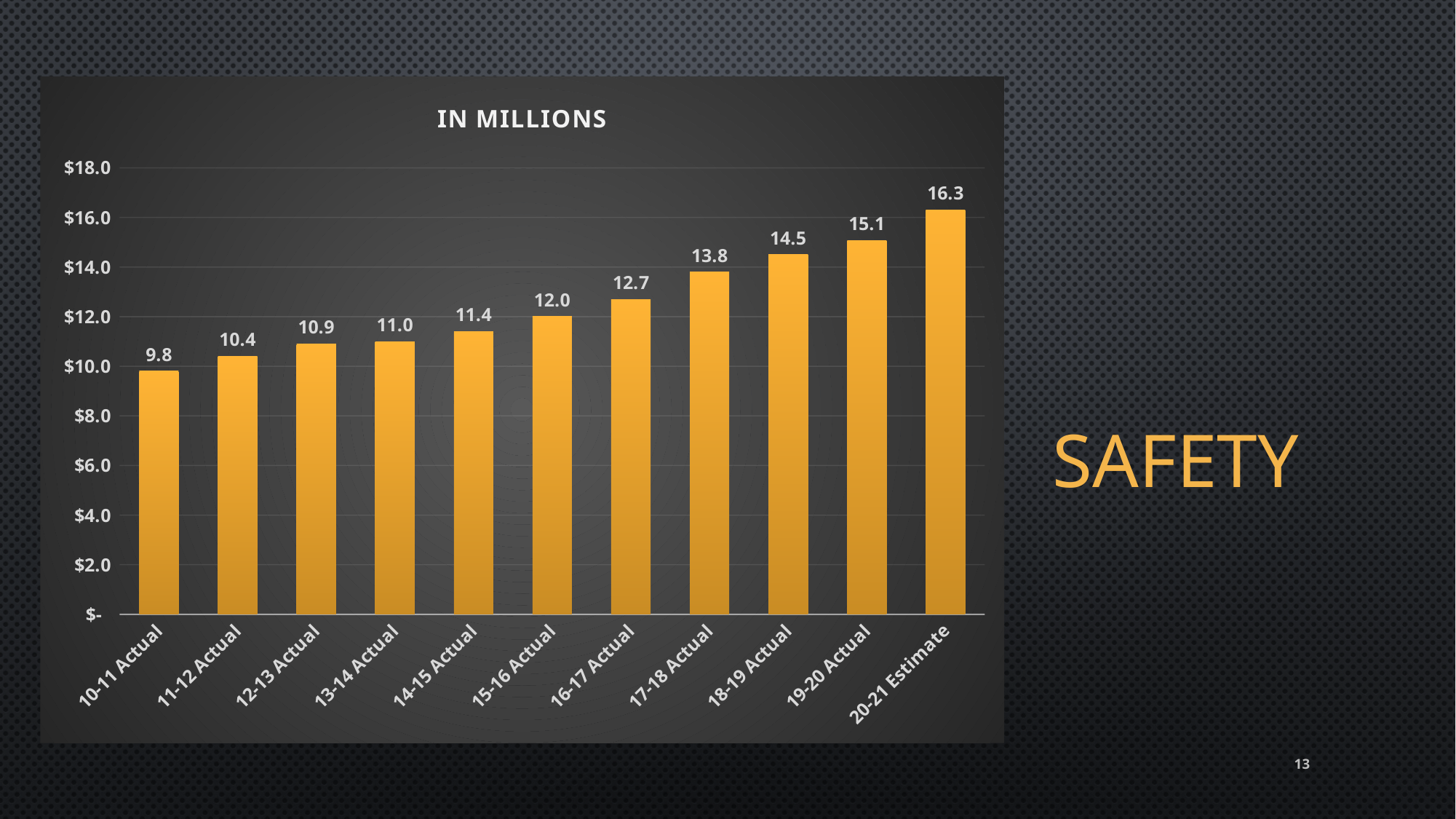
What is the value for 20-21 Estimate? 16.3 What is the difference between the values for 20-21 Estimate and 19-20 Actual? 1.2 Which category has the lowest value? 10-11 Actual Which is larger, the value for 13-14 Actual or the value for 17-18 Actual? 17-18 Actual How many categories are shown on the x axis? 11 Which category has the highest value? 20-21 Estimate Do the values rise or fall from 10-11 Actual to 20-21 Estimate? rise What is the difference between the values for 15-16 Actual and 10-11 Actual? 2.2 What is the value for 10-11 Actual? 9.8 Is the value for 18-19 Actual greater or less than $14.0? greater What is the value for 16-17 Actual? 12.7 What kind of chart is shown on the slide? bar chart